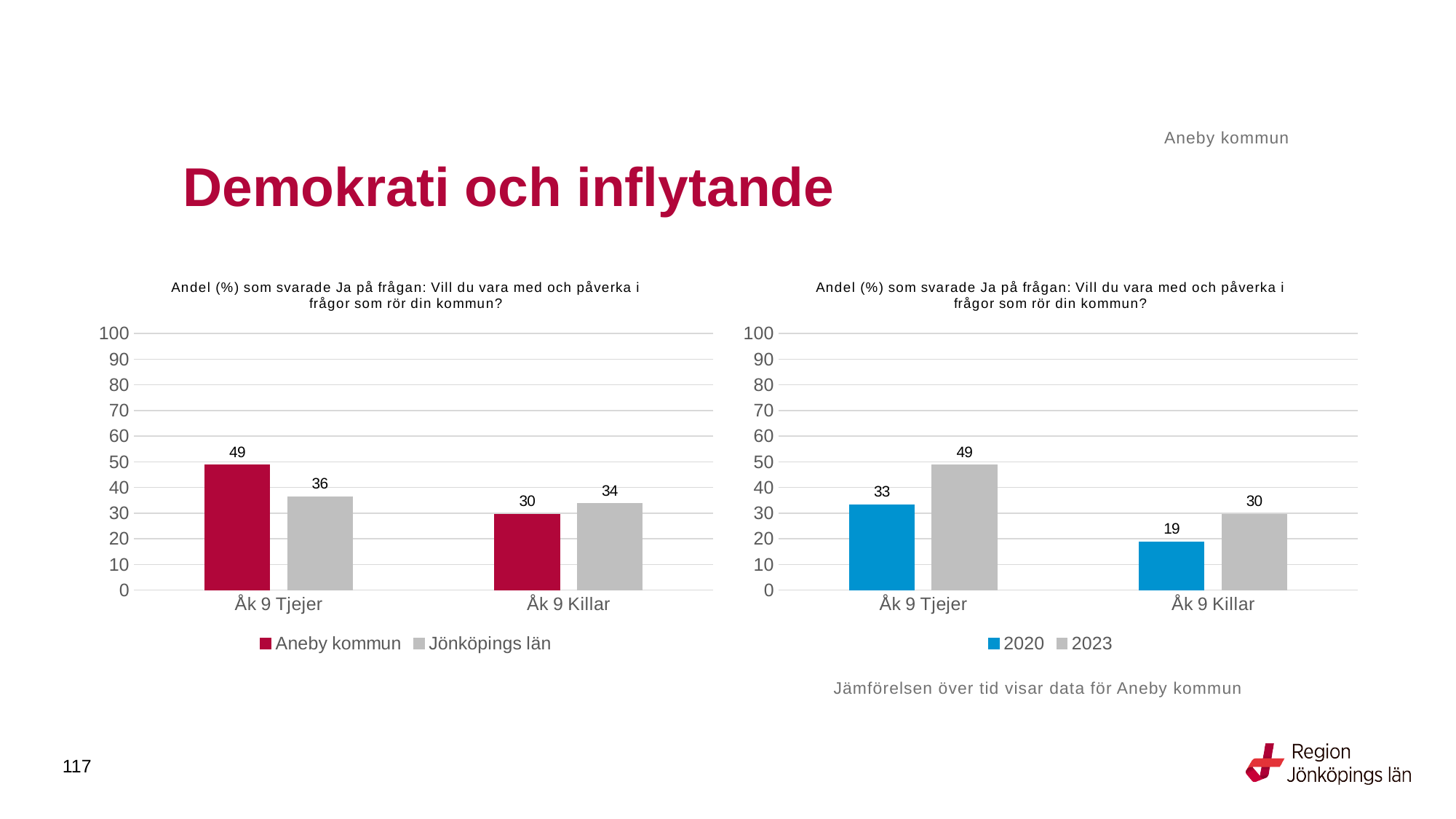
In the right chart, what is the value for 2023 for Åk 9 Tjejer? 49 In the right chart, what is the difference between 2023 and 2020 for Åk 9 Tjejer? 16 In the left chart, which is larger for Åk 9 Killar: Aneby kommun or Jönköpings län? Jönköpings län In the right chart, how many categories are shown on the x axis? 2 In the left chart, what is the difference between Aneby kommun and Jönköpings län for Åk 9 Tjejer? 13 In the right chart, what is the value for 2020 for Åk 9 Killar? 19 In the left chart, what is the value for Jönköpings län for Åk 9 Killar? 34 In the left chart, what is the value for Aneby kommun for Åk 9 Tjejer? 49 In the right chart, which category has the lowest value for 2020? Åk 9 Killar In the left chart, how many series does the legend list? 2 What kind of chart is the right chart? Bar chart In the right chart, what are the two legend entries? 2020 and 2023